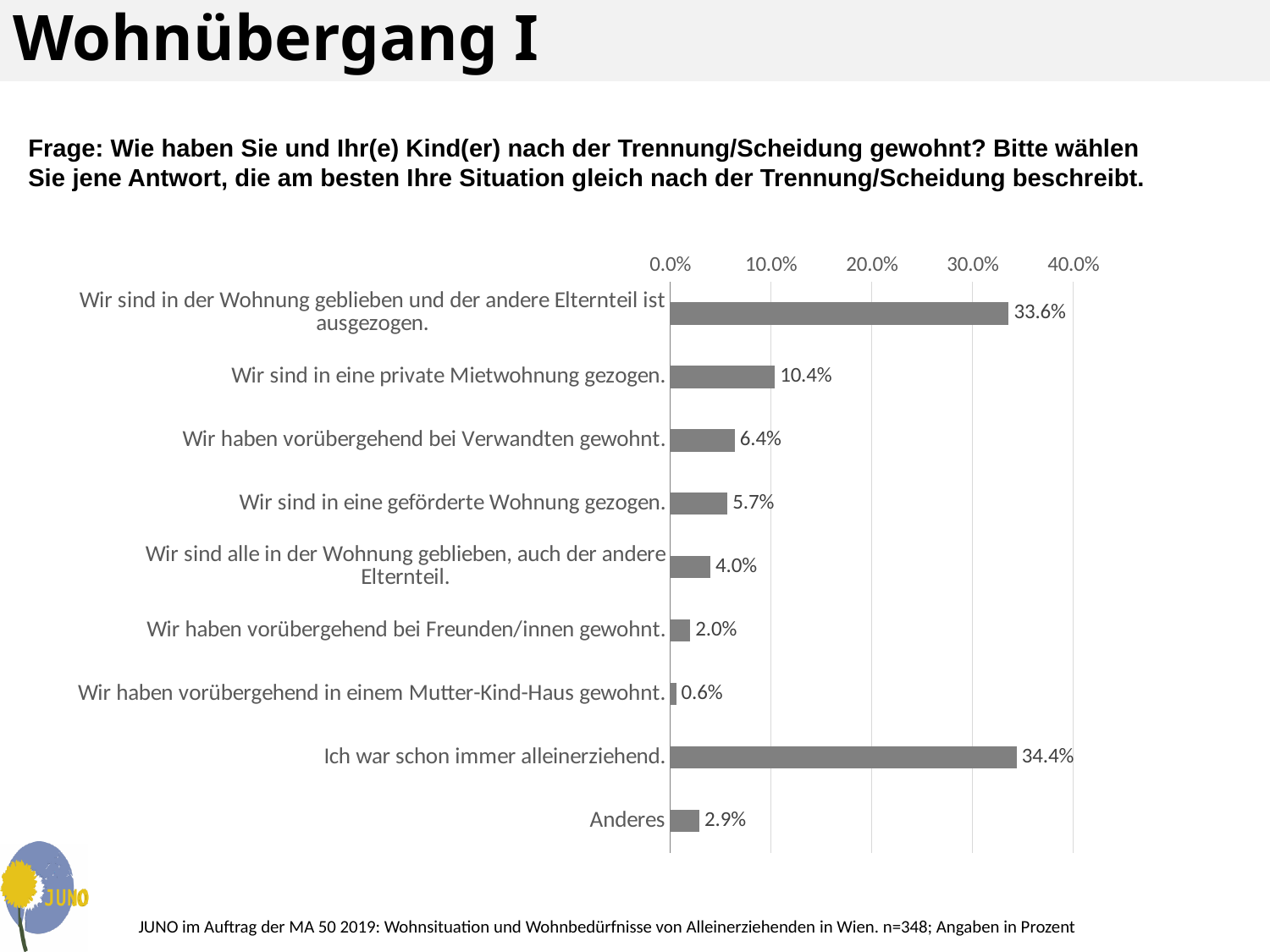
Which category has the highest value? Ich war schon immer alleinerziehend. What is the difference between the values for "Ich war schon immer alleinerziehend." and "Wir sind in der Wohnung geblieben und der andere Elternteil ist ausgezogen."? 0.8% What is the value for "Wir haben vorübergehend in einem Mutter-Kind-Haus gewohnt."? 0.6% How many categories are shown in the chart? 9 Is the value for "Wir sind in der Wohnung geblieben und der andere Elternteil ist ausgezogen." greater or less than 30.0%? greater Which category has the lowest value? Wir haben vorübergehend in einem Mutter-Kind-Haus gewohnt. What kind of chart is shown on the slide? bar chart What is the value for "Wir sind in eine private Mietwohnung gezogen."? 10.4% What is the difference between the values for "Wir sind in eine private Mietwohnung gezogen." and "Wir haben vorübergehend bei Freunden/innen gewohnt."? 8.4% What is the value for "Anderes"? 2.9% What is the value for "Ich war schon immer alleinerziehend."? 34.4% Which is larger: the value for "Wir haben vorübergehend bei Verwandten gewohnt." or for "Wir sind in eine geförderte Wohnung gezogen."? Wir haben vorübergehend bei Verwandten gewohnt.